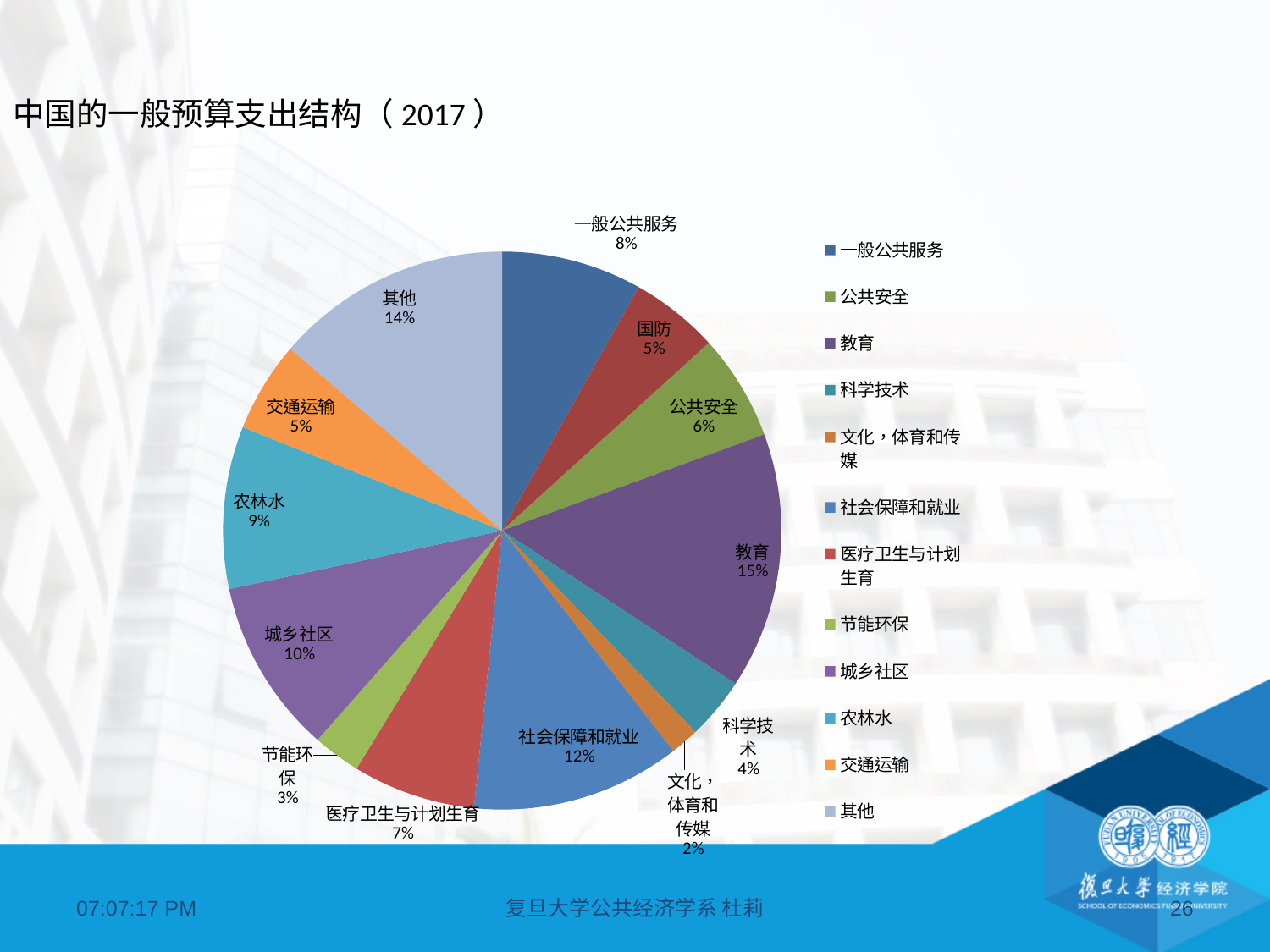
What kind of chart is shown on the slide? Pie chart Which category has the smallest slice of the pie? 文化，体育和传媒 What share of the pie does 教育 account for? 15% What is the combined share of 国防 and 交通运输? 10% What is the difference in percentage points between 其他 and 城乡社区? 4 What percentage is shown for 社会保障和就业? 12% Which is larger, the share for 医疗卫生与计划生育 or the share for 公共安全? 医疗卫生与计划生育 What is the value labelled for 农林水? 9% What is the title of the slide containing the chart? 中国的一般预算支出结构（2017） Which category has the largest slice of the pie? 教育 How many entries does the legend list? 12 How many slices does the pie chart have? 13